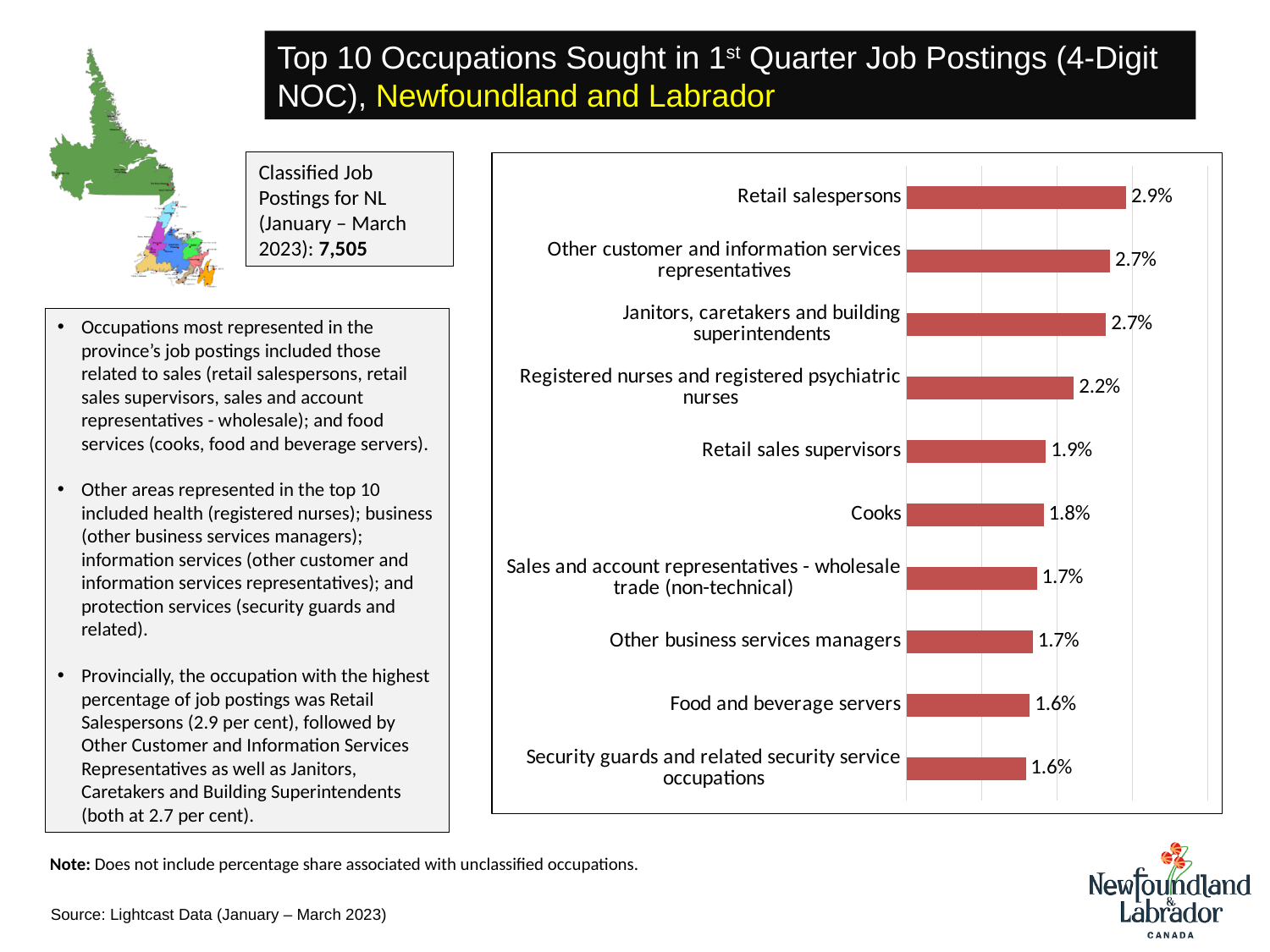
Which occupation has the highest percentage in the chart? Retail salespersons Which has a larger value, Retail sales supervisors or Food and beverage servers? Retail sales supervisors What percentage of job postings is shown for Retail salespersons? 2.9% What kind of chart is shown on the slide? Bar chart What is the difference between the values for Retail sales supervisors and Cooks? 0.1 percentage points What value is shown for Retail sales supervisors? 1.9% What value is shown for Cooks? 1.8% How many occupations are shown in the chart? 10 What value is shown for Registered nurses and registered psychiatric nurses? 2.2% What is the difference between the values for Retail salespersons and Registered nurses and registered psychiatric nurses? 0.7 percentage points Which has a larger value, Cooks or Registered nurses and registered psychiatric nurses? Registered nurses and registered psychiatric nurses What value is shown for Food and beverage servers? 1.6%